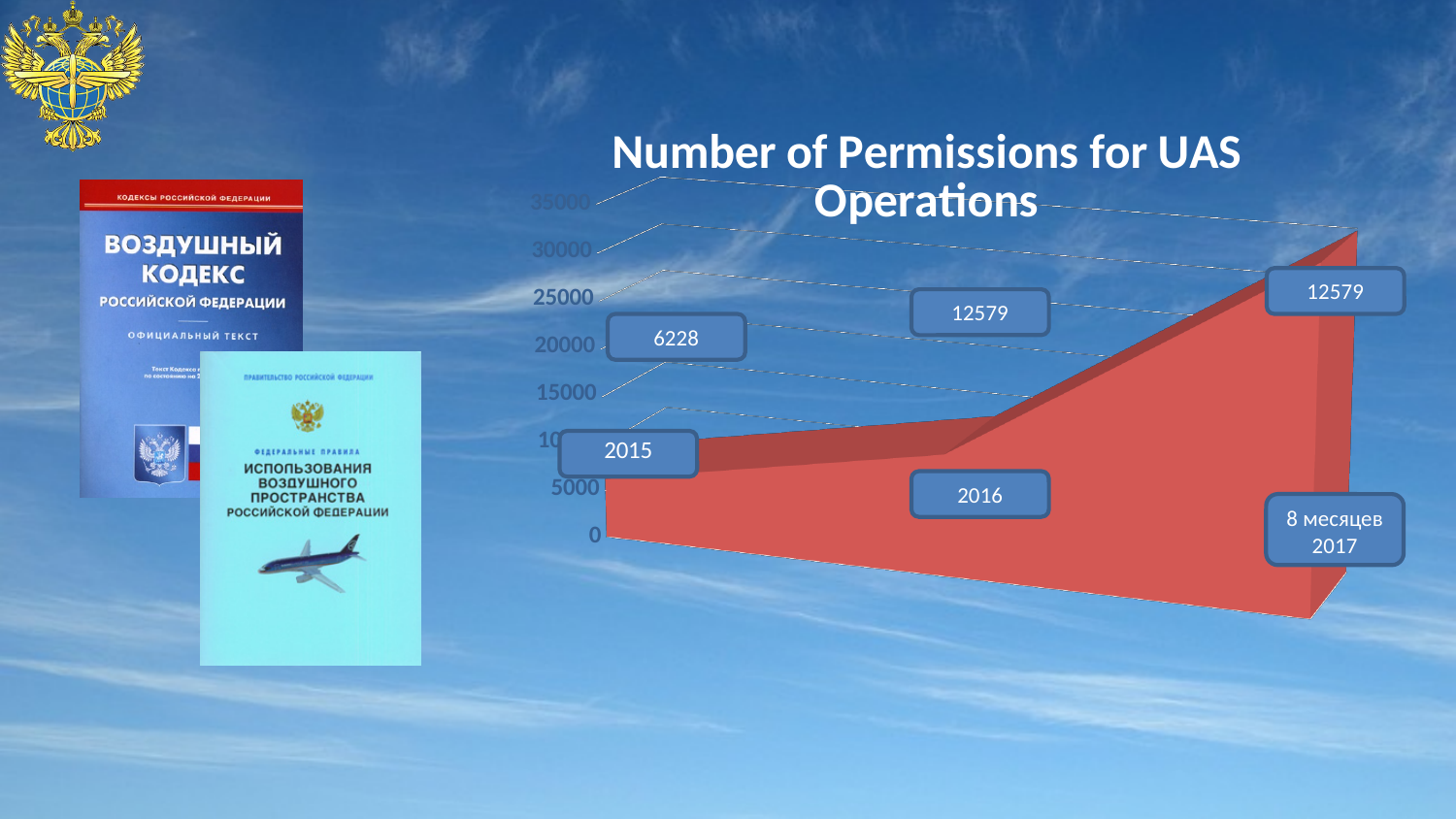
What is the number of permissions for UAS operations in 2016? 12579 Is the value for 2016 greater or less than 10000? greater Is the value for 2015 greater or less than 10000? less Which category has the lowest number of permissions? 2015 What kind of chart is used to show the number of permissions? Area chart What is the title of the chart? Number of Permissions for UAS Operations Which year had more permissions, 2015 or 2016? 2016 What is the highest value shown on the vertical axis of the chart? 35000 How many categories are shown on the x axis of the chart? 3 What is the number of permissions for UAS operations in 2015? 6228 Do the values rise or fall from 2015 to 8 месяцев 2017? Rise By how much did the number of permissions increase from 2015 to 2016? 6351